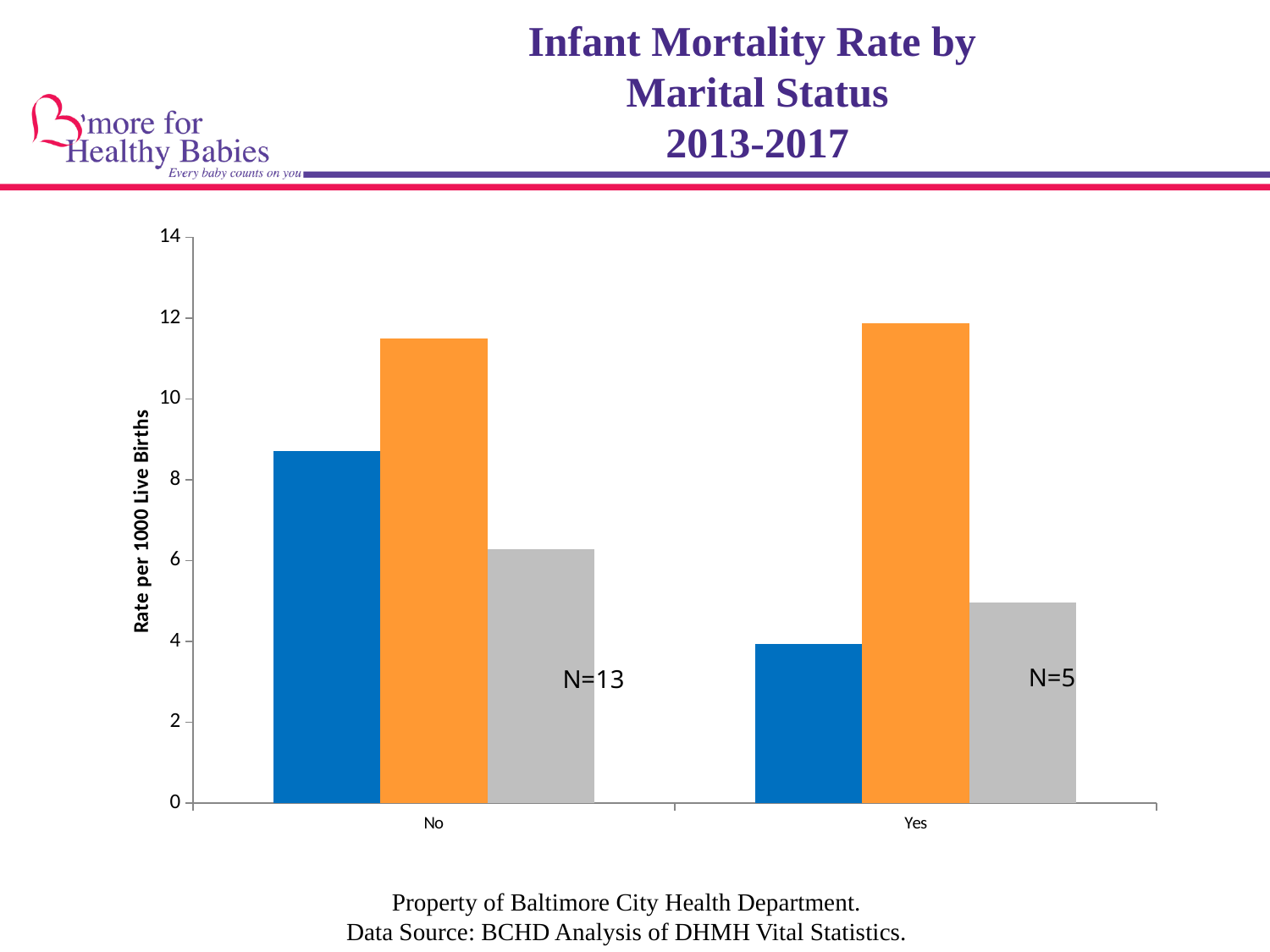
Is the value of the blue bar for 'No' greater or less than 8? greater Which coloured bar is the lowest in the 'Yes' group? blue Which coloured bar is the highest in the 'No' group? orange What kind of chart is shown on the slide? bar chart Is the blue bar larger for 'No' or for 'Yes'? No What N value is printed next to the 'No' group of bars? N=13 Is the value of the orange bar for 'Yes' greater or less than 10? greater How many marital status categories are shown on the x axis? 2 Is the value of the gray bar for 'Yes' greater or less than 6? less What is the label on the y axis? Rate per 1000 Live Births What N value is printed next to the 'Yes' group of bars? N=5